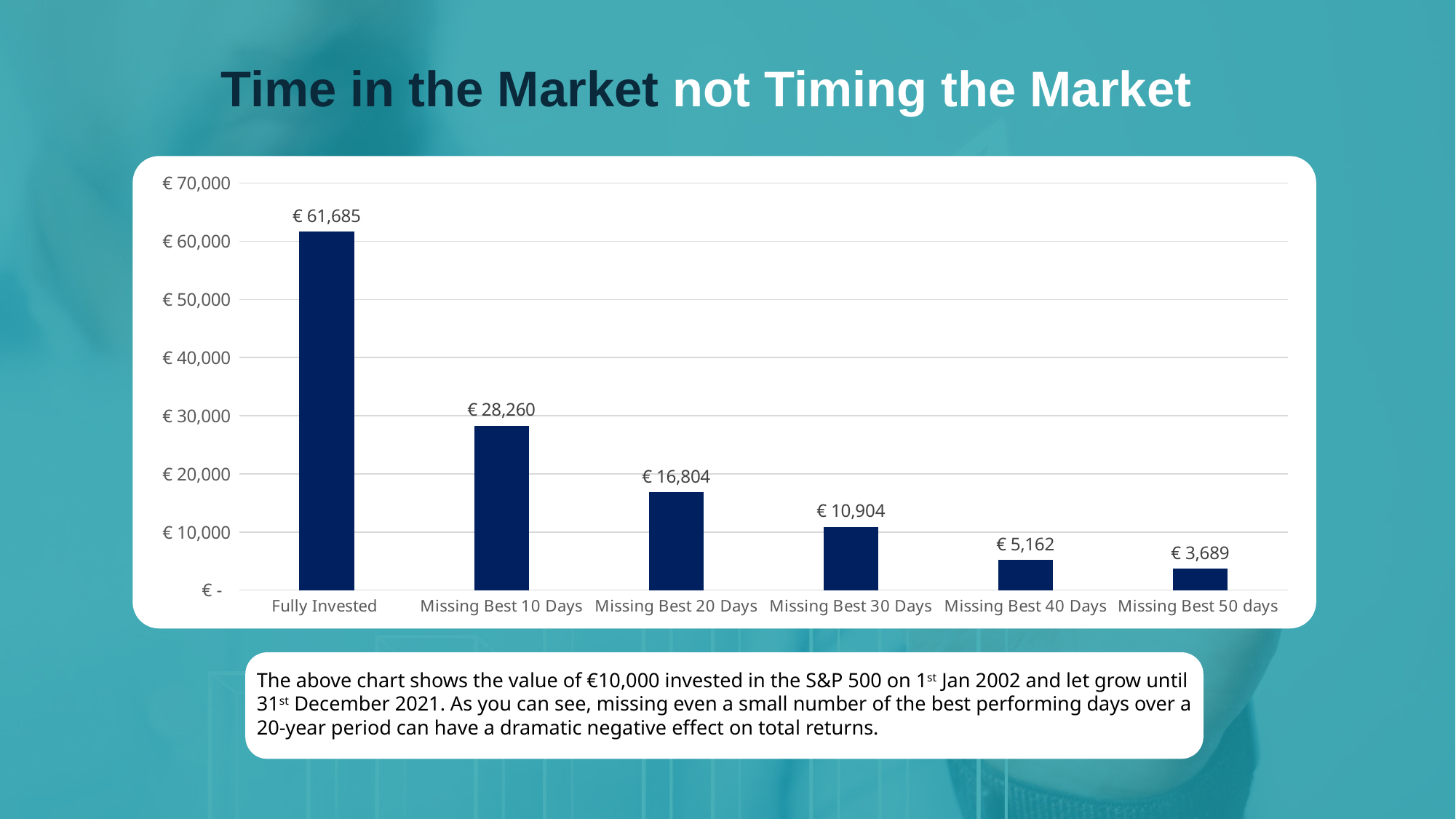
Is the value for Missing Best 20 Days greater or less than € 20,000? less Which category has the highest value? Fully Invested What is the value for Missing Best 50 days? € 3,689 How many categories are shown on the x axis? 6 Which category has the lowest value? Missing Best 50 days What is the value for Missing Best 20 Days? € 16,804 What kind of chart is shown on the slide? Bar chart What is the difference between the values for Missing Best 30 Days and Missing Best 40 Days? € 5,742 Which is larger, the value for Missing Best 10 Days or Missing Best 30 Days? Missing Best 10 Days What is the value for Fully Invested? € 61,685 What is the difference between the values for Fully Invested and Missing Best 10 Days? € 33,425 Do the values rise or fall from left to right along the x axis? Fall